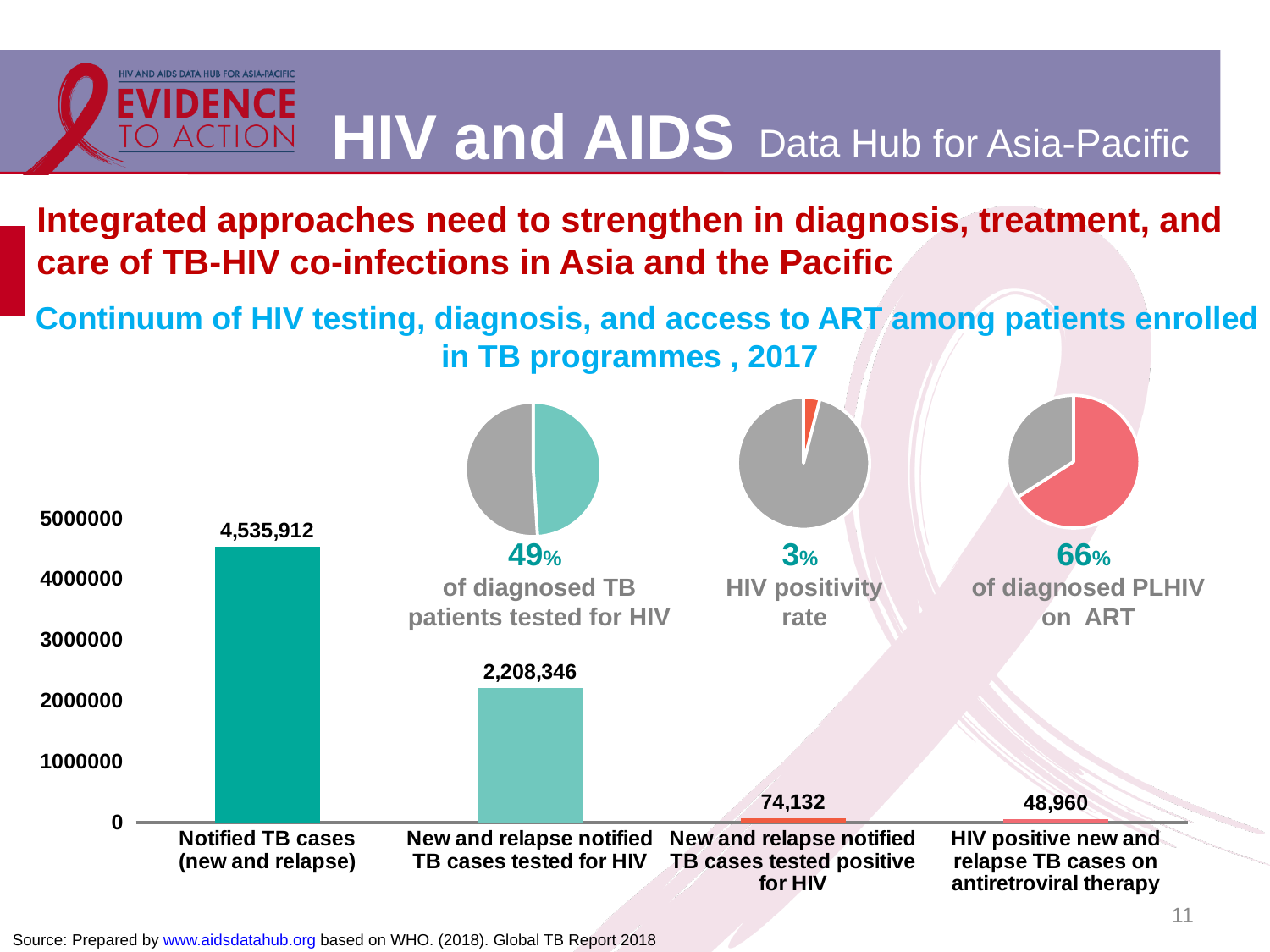
In the bar chart, what is the value for Notified TB cases (new and relapse)? 4,535,912 What kind of chart shows the four TB case categories at the bottom of the slide? Bar chart In the bar chart, what is the difference between Notified TB cases (new and relapse) and New and relapse notified TB cases tested for HIV? 2,327,566 In the bar chart, which category has the lowest value? HIV positive new and relapse TB cases on antiretroviral therapy In the bar chart, how many categories are shown on the x axis? 4 In the bar chart, what is the value for New and relapse notified TB cases tested for HIV? 2,208,346 In the bar chart, what is the value for New and relapse notified TB cases tested positive for HIV? 74,132 In the pie chart labelled 'of diagnosed PLHIV on ART', what share is shown? 66% In the bar chart, what is the value for HIV positive new and relapse TB cases on antiretroviral therapy? 48,960 Do the values in the bar chart rise or fall from left to right along the x axis? Fall In the bar chart, what is the difference between New and relapse notified TB cases tested positive for HIV and HIV positive new and relapse TB cases on antiretroviral therapy? 25,172 In the bar chart, which category has the highest value? Notified TB cases (new and relapse)